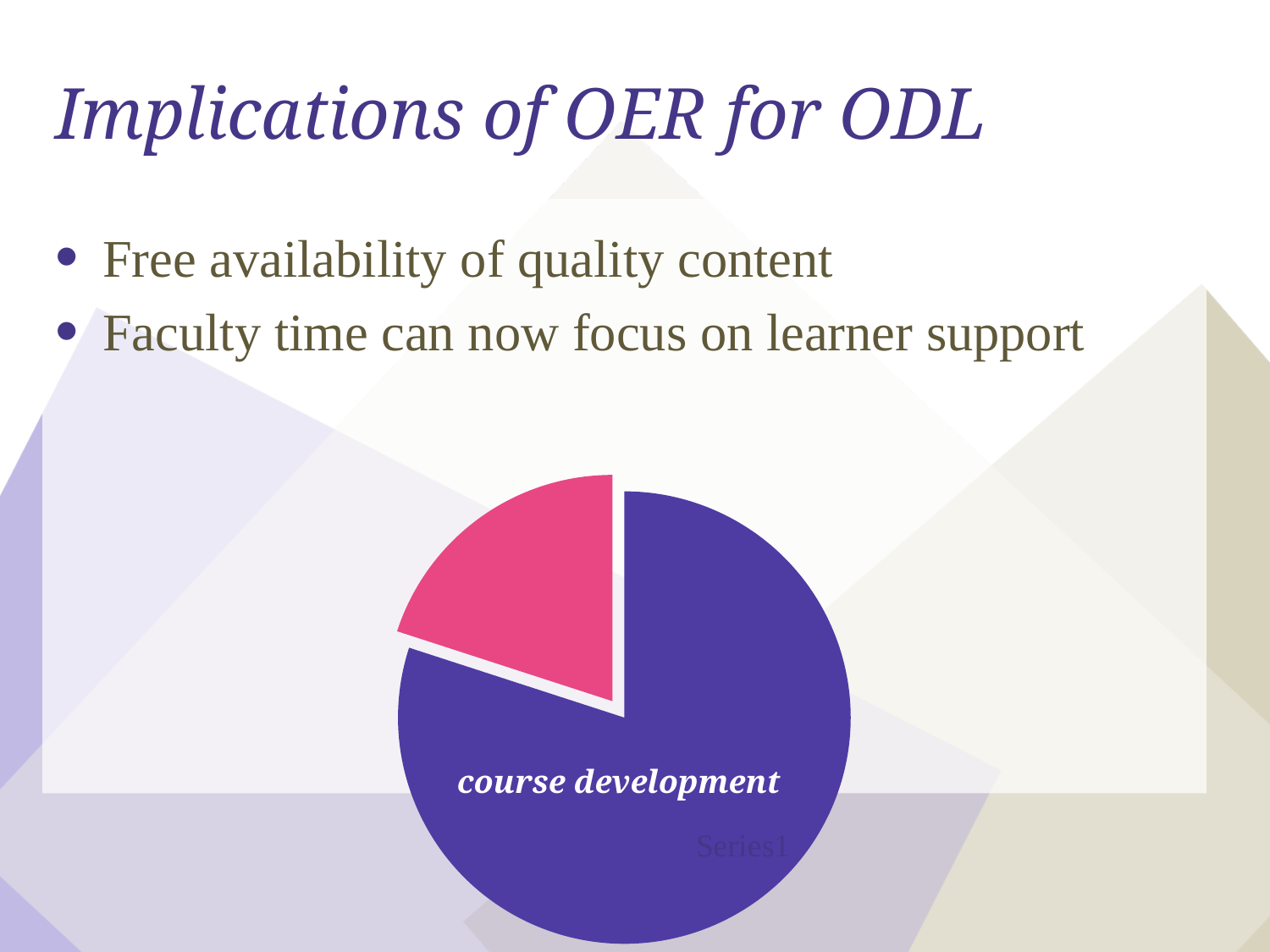
Does the 'course development' slice take up more or less than half of the pie? more Which slice of the pie chart is the largest? course development Is the 'course development' slice larger or smaller than the pink slice? larger Which slice is larger, the purple slice or the pink slice? the purple slice How many slices does the pie chart have? 2 What kind of chart is shown on the slide? pie chart What series name is shown on the pie chart? Series1 What label is printed on the large purple slice of the pie chart? course development